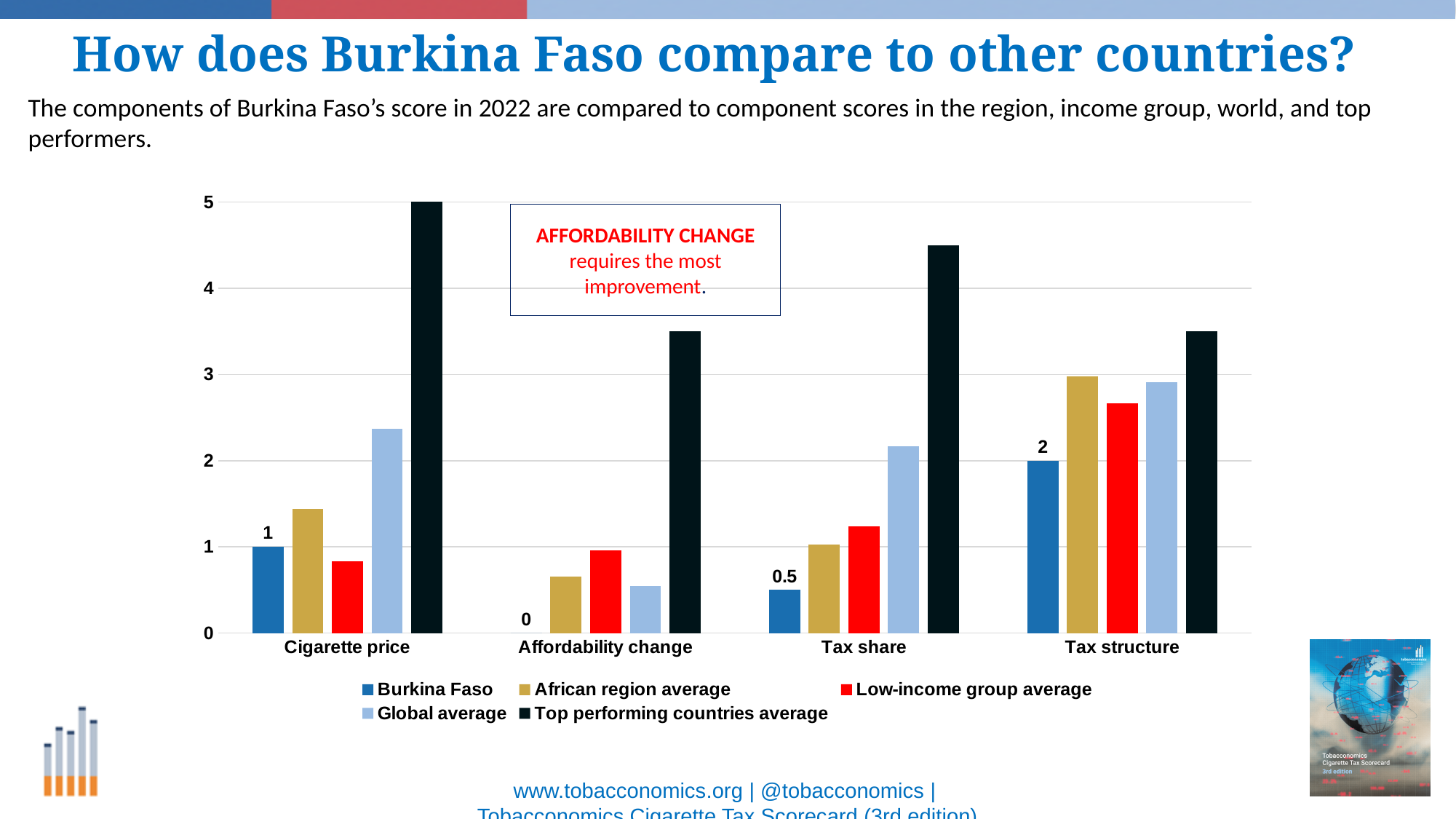
In which category does Burkina Faso have its lowest score? Affordability change What type of chart is shown on the slide? bar chart What is the value for Burkina Faso in the Tax share category? 0.5 What is the value for Burkina Faso in the Tax structure category? 2 In which category does Burkina Faso have its highest score? Tax structure How many categories are shown on the x axis of the chart? 4 Is the Top performing countries average for Tax share greater or less than 4? greater What is the value for Burkina Faso in the Affordability change category? 0 How many series does the chart's legend list? 5 Is the Global average for Cigarette price greater or less than 2? greater What is the value for Burkina Faso in the Cigarette price category? 1 What is the difference between Burkina Faso's Tax structure score and its Cigarette price score? 1